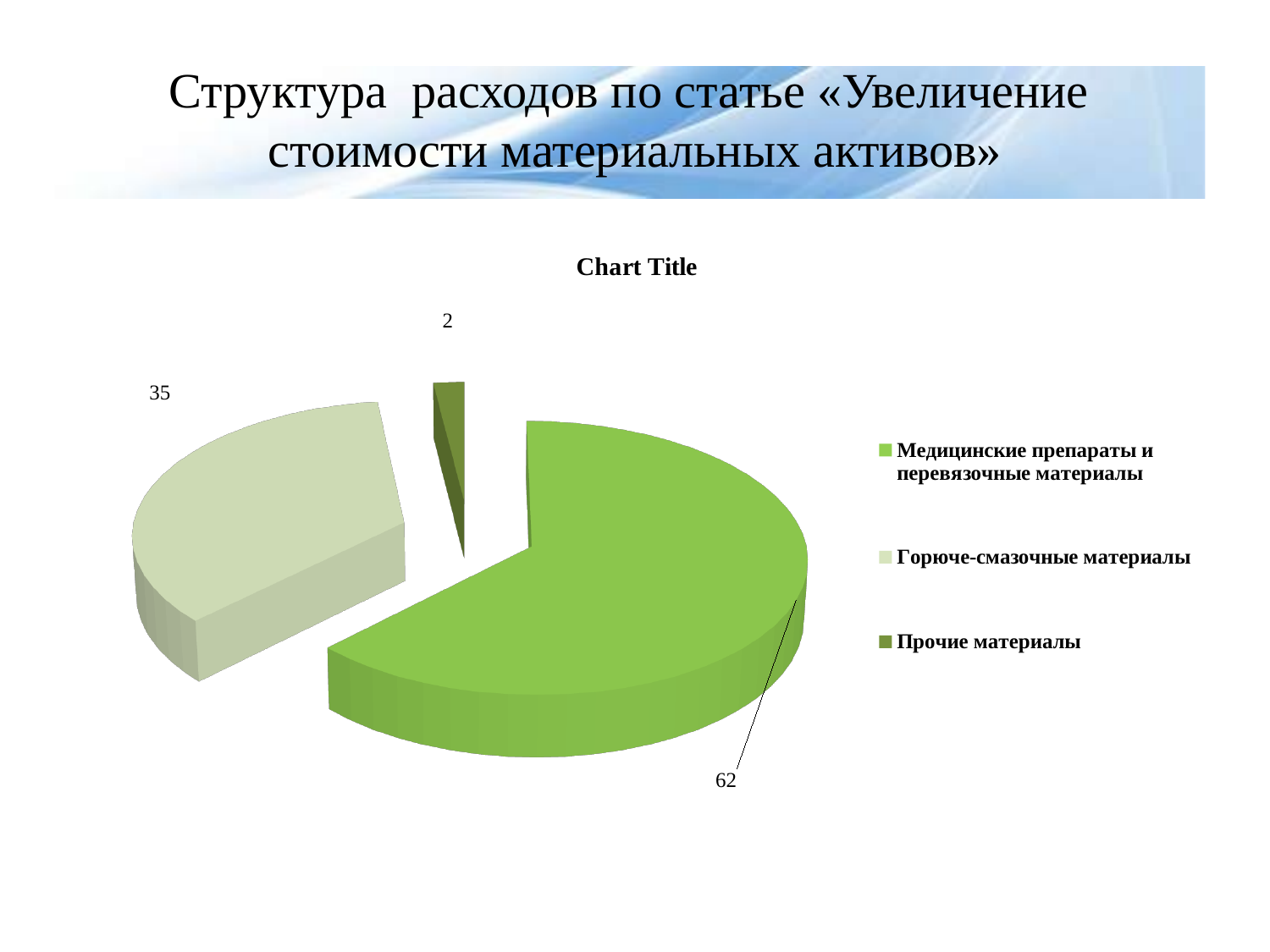
What is the difference between the values for Медицинские препараты и перевязочные материалы and Горюче-смазочные материалы? 27 Which legend entry is shown in the lightest colour? Горюче-смазочные материалы What is the value for Прочие материалы? 2 Which category has the smallest slice of the pie? Прочие материалы Which is larger: the value for Горюче-смазочные материалы or the value for Прочие материалы? Горюче-смазочные материалы What is the value for Горюче-смазочные материалы? 35 How many categories does the pie chart have? 3 Which category has the largest slice of the pie? Медицинские препараты и перевязочные материалы What type of chart is shown on the slide? Pie chart What is the value for Медицинские препараты и перевязочные материалы? 62 What is the title shown above the pie chart? Chart Title What is the difference between the values for Горюче-смазочные материалы and Прочие материалы? 33